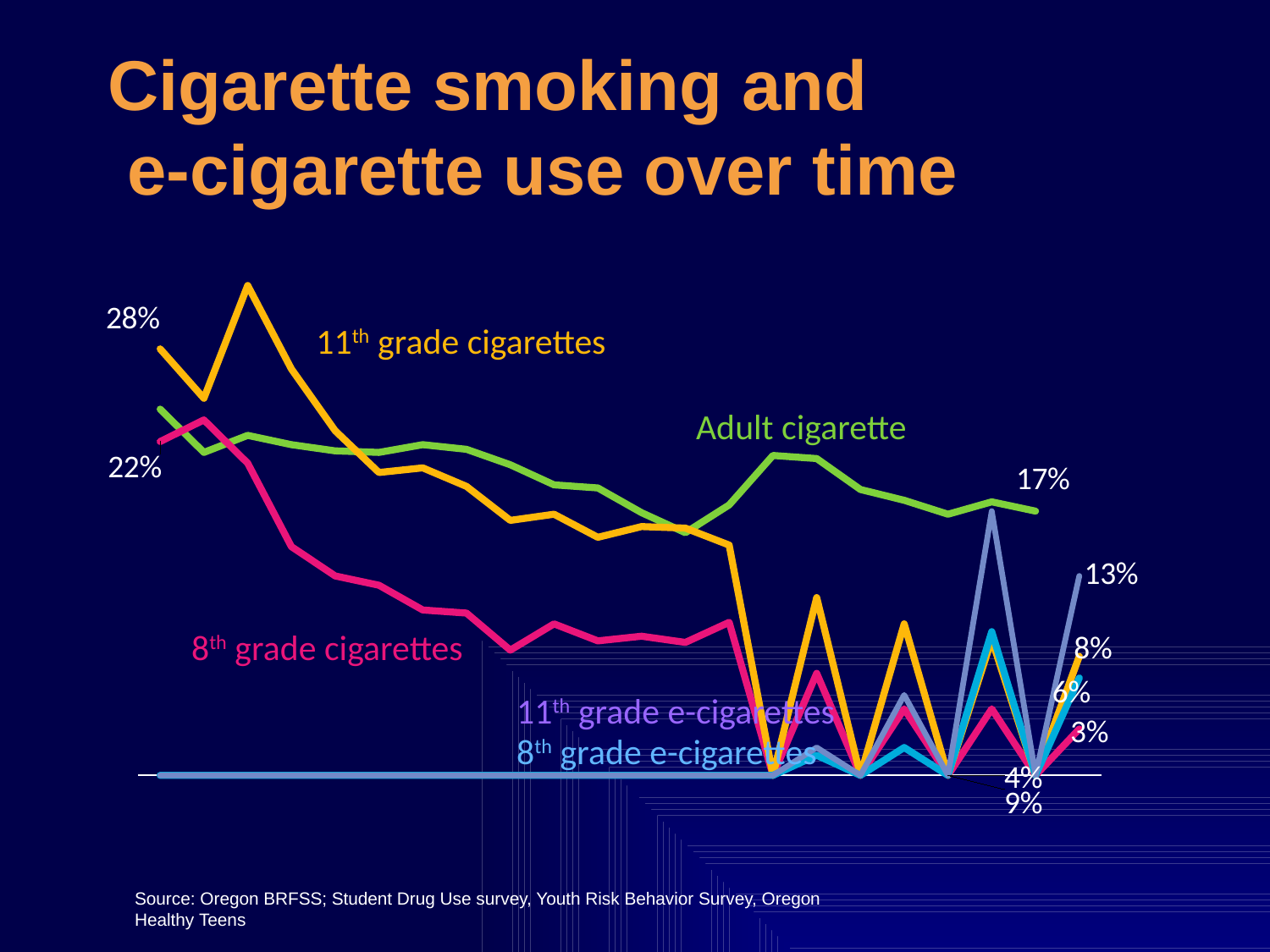
What kind of chart is shown on the slide? line chart What is the final value labelled for 11th grade cigarettes? 8% What is the final value labelled for Adult cigarette? 17% Which series has the highest value at the end of the chart? Adult cigarette At the end of the chart, which is larger: Adult cigarette or 11th grade e-cigarettes? Adult cigarette What is the title of the slide? Cigarette smoking and e-cigarette use over time Which series has the highest value at the start of the chart? 11th grade cigarettes What is the difference between the final Adult cigarette value (17%) and the final 11th grade e-cigarettes value (13%)? 4% How many data series are labelled on the chart? 5 Does the 11th grade cigarettes series rise or fall over time? fall What is the final value labelled for 11th grade e-cigarettes? 13% What is the starting value labelled for 11th grade cigarettes? 28%